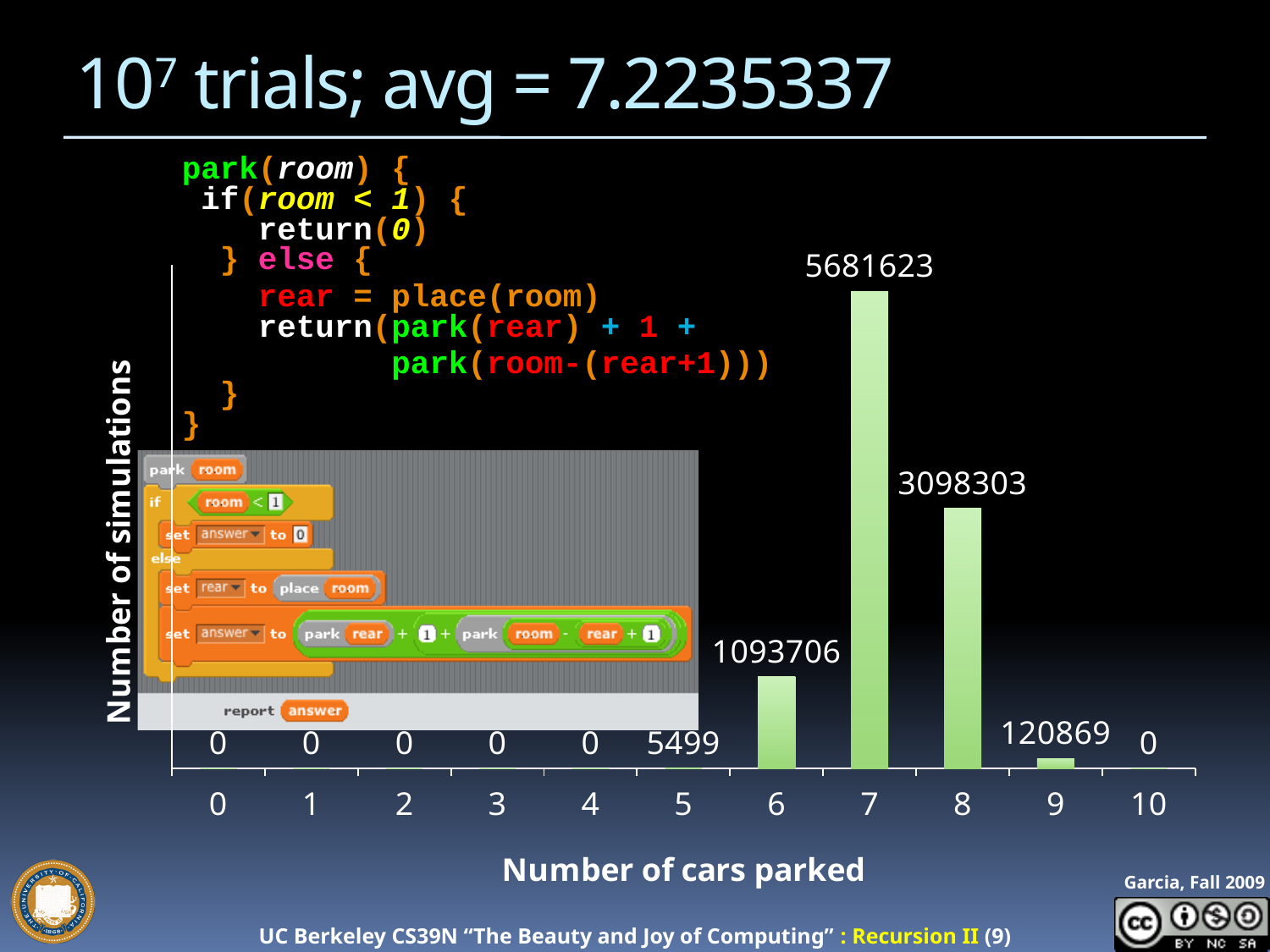
What is the label of the x axis of the chart? Number of cars parked What is the label of the y axis of the chart? Number of simulations What is the total number of simulations for 5, 6 and 7 cars parked combined? 6780828 Which has more simulations: 6 cars parked or 8 cars parked? 8 cars parked What is the number of simulations for 6 cars parked? 1093706 What kind of chart is shown on the slide? bar chart What is the number of simulations for 9 cars parked? 120869 What is the difference in number of simulations between 7 cars parked and 8 cars parked? 2583320 How many categories are shown on the x axis of the chart? 11 Which number of cars parked has the highest number of simulations? 7 What is the number of simulations for 5 cars parked? 5499 What is the number of simulations for 7 cars parked? 5681623